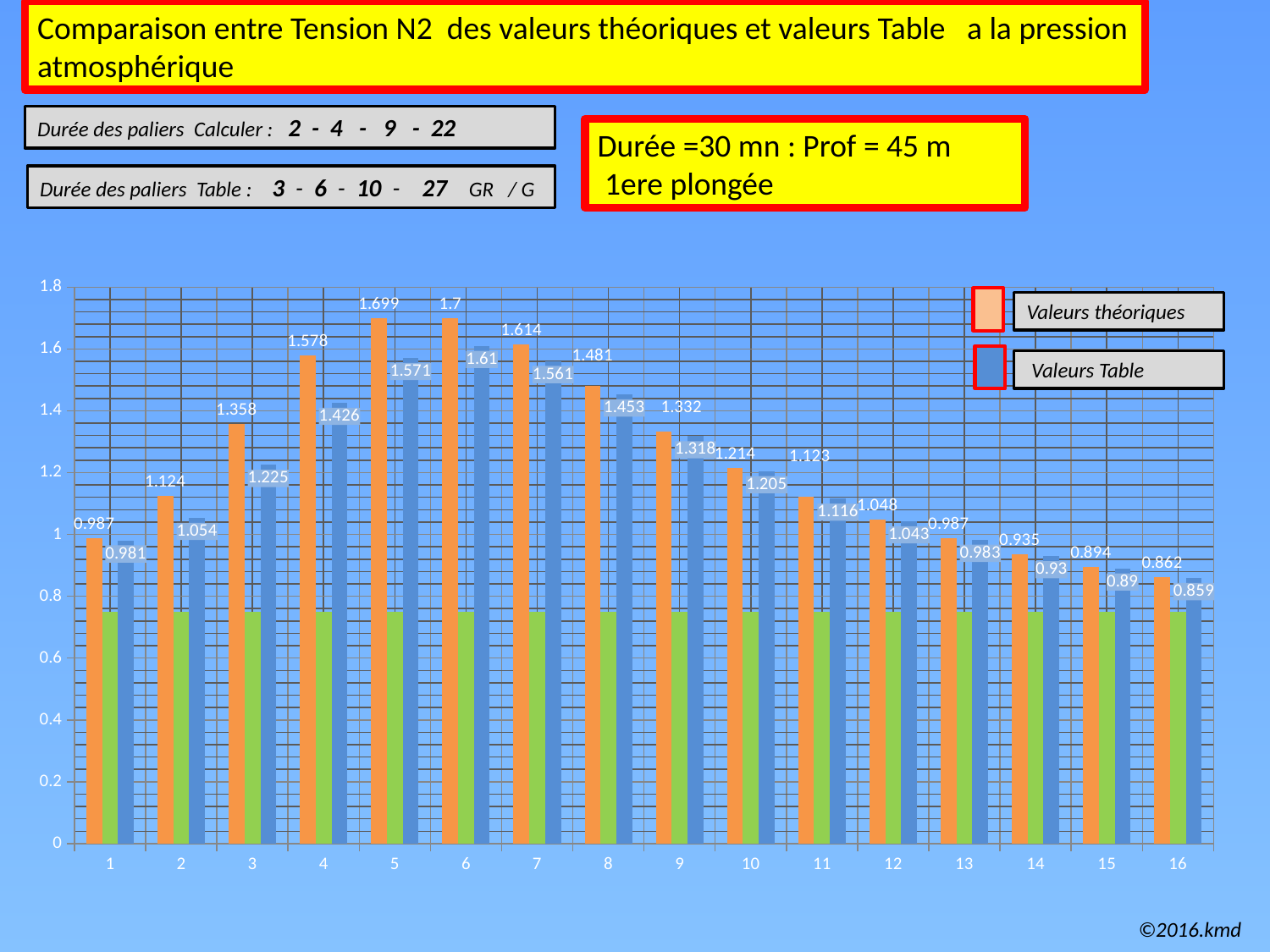
Do the Valeurs théoriques values rise or fall from category 6 to category 16? Fall Which category has the highest Valeurs Table value? 6 How many categories are shown on the x axis? 16 What is the Valeurs théoriques value for category 6? 1.7 What is the difference between the Valeurs théoriques and Valeurs Table values for category 3? 0.133 Is the Valeurs Table value for category 5 greater or less than 1.4? greater What is the Valeurs théoriques value for category 13? 0.987 Which category has the lowest Valeurs théoriques value? 16 How many series does the legend list? 2 What is the Valeurs Table value for category 4? 1.426 Which is larger for category 2: the Valeurs théoriques value or the Valeurs Table value? Valeurs théoriques What kind of chart is shown on the slide? Bar chart